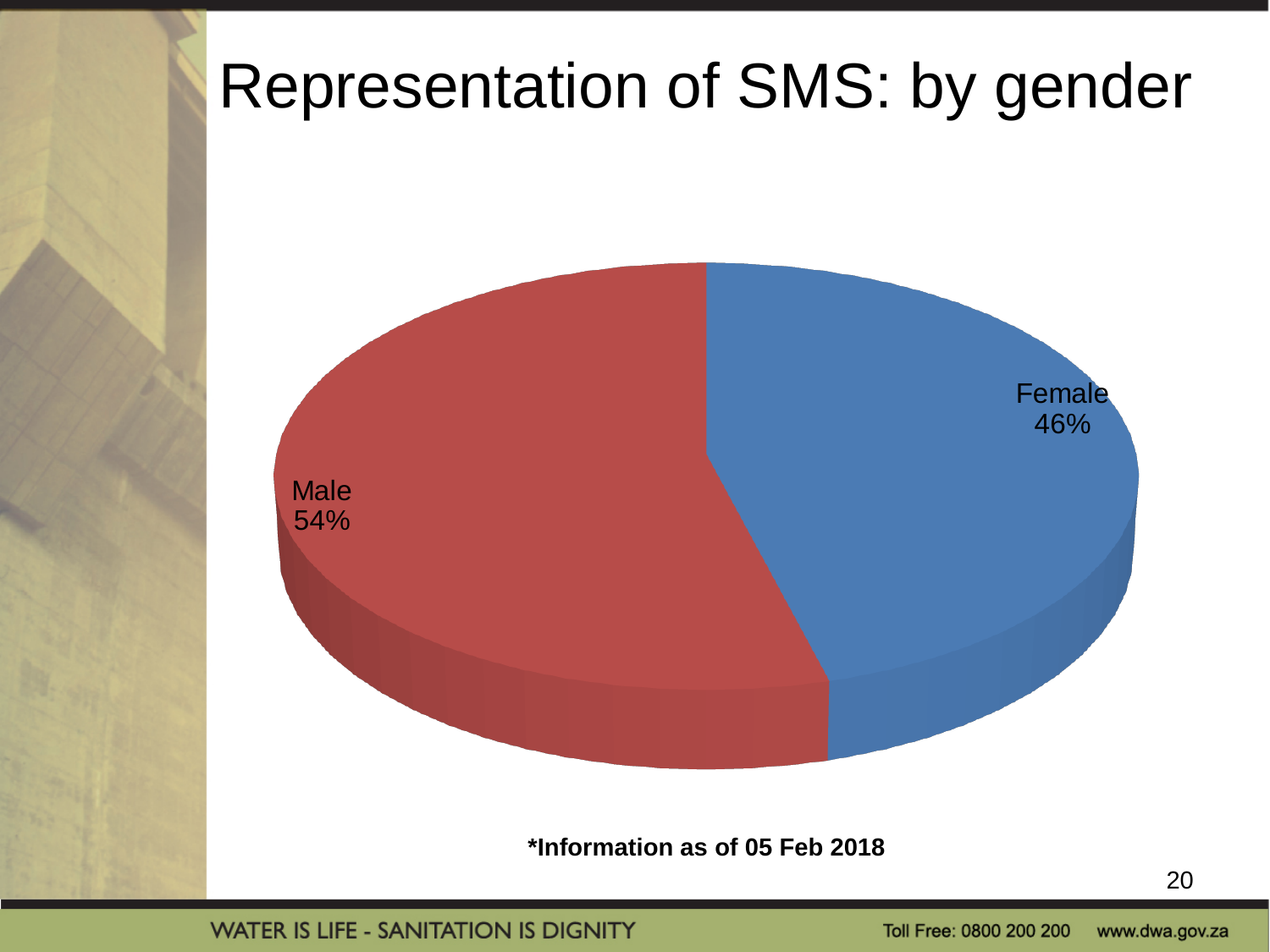
What is the combined share of the Male and Female slices? 100% What colour is the Male slice of the pie chart? Red Is the female share greater or less than 50%? less What type of chart is shown on the slide? Pie chart Which gender has the smaller share of SMS? Female What is the title of the slide containing the chart? Representation of SMS: by gender Which gender has the larger share of SMS? Male What is the difference in percentage points between the male and female shares? 8 What percentage of SMS members are male? 54% How many slices does the pie chart have? 2 Is the male share larger or smaller than the female share? Larger What percentage of SMS members are female? 46%